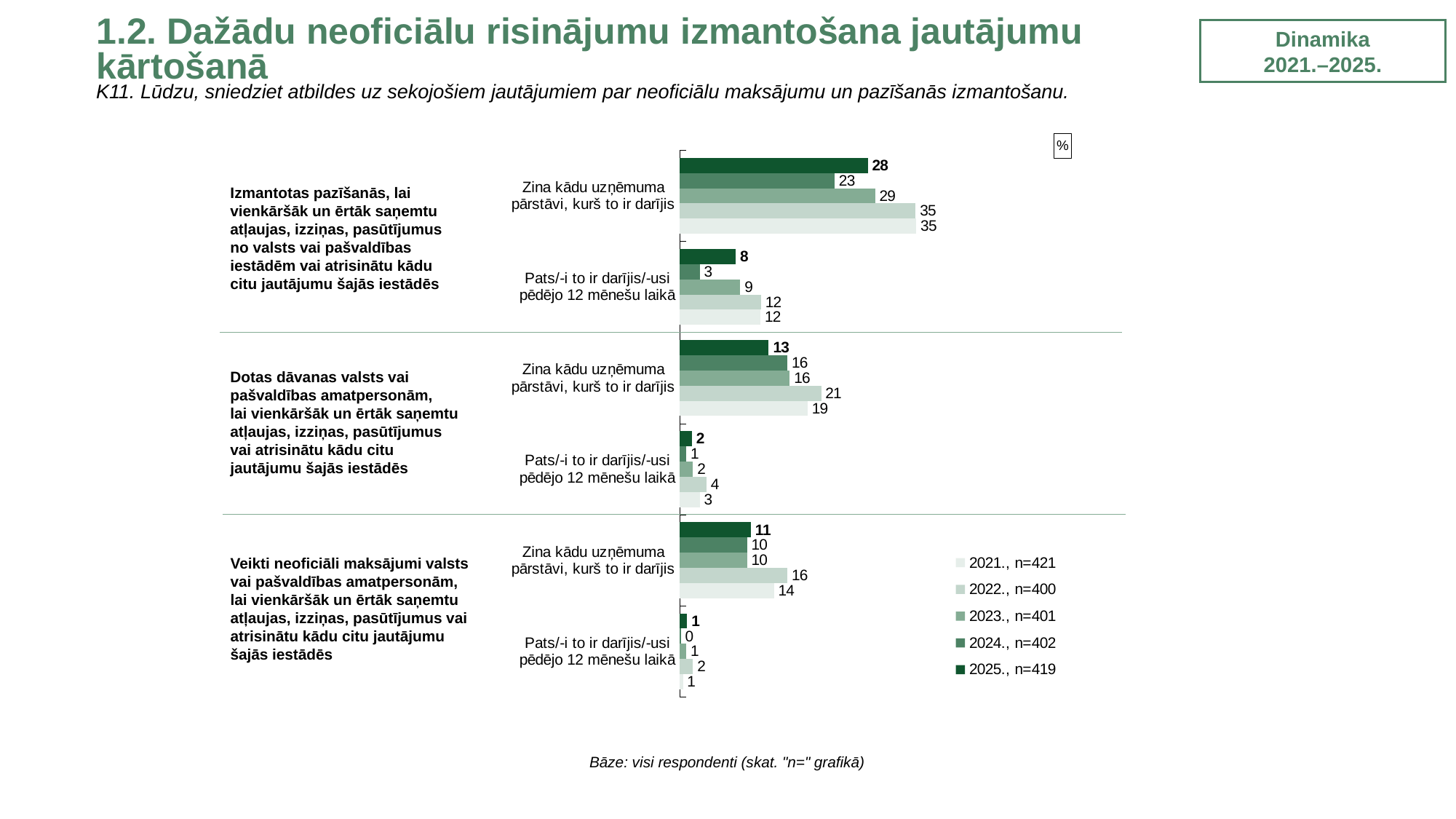
How many series does the legend list? 5 In the "Dotas dāvanas" section, which year has the highest value for "Zina kādu uzņēmuma pārstāvi, kurš to ir darījis"? 2022 In the "Izmantotas pazīšanās" section, what is the difference between the 2021 and 2025 values for "Pats/-i to ir darījis/-usi pēdējo 12 mēnešu laikā"? 4 What type of chart is shown on the slide? bar chart What is the 2024 value for "Pats/-i to ir darījis/-usi pēdējo 12 mēnešu laikā" in the "Izmantotas pazīšanās" section? 3 What is the 2022 value for "Zina kādu uzņēmuma pārstāvi, kurš to ir darījis" in the "Dotas dāvanas" section? 21 In the "Veikti neoficiāli maksājumi" section, what is the difference between the 2022 and 2025 values for "Zina kādu uzņēmuma pārstāvi, kurš to ir darījis"? 5 In the "Izmantotas pazīšanās" section, which year has the lowest value for "Zina kādu uzņēmuma pārstāvi, kurš to ir darījis"? 2024 What sample size (n) does the legend give for 2023? n=401 What is the 2024 value for "Pats/-i to ir darījis/-usi pēdējo 12 mēnešu laikā" in the "Veikti neoficiāli maksājumi" section? 0 In the "Dotas dāvanas" section, is the 2025 value for "Zina kādu uzņēmuma pārstāvi" larger or smaller than the 2024 value? smaller What is the 2025 value for "Zina kādu uzņēmuma pārstāvi, kurš to ir darījis" in the "Izmantotas pazīšanās" section? 28